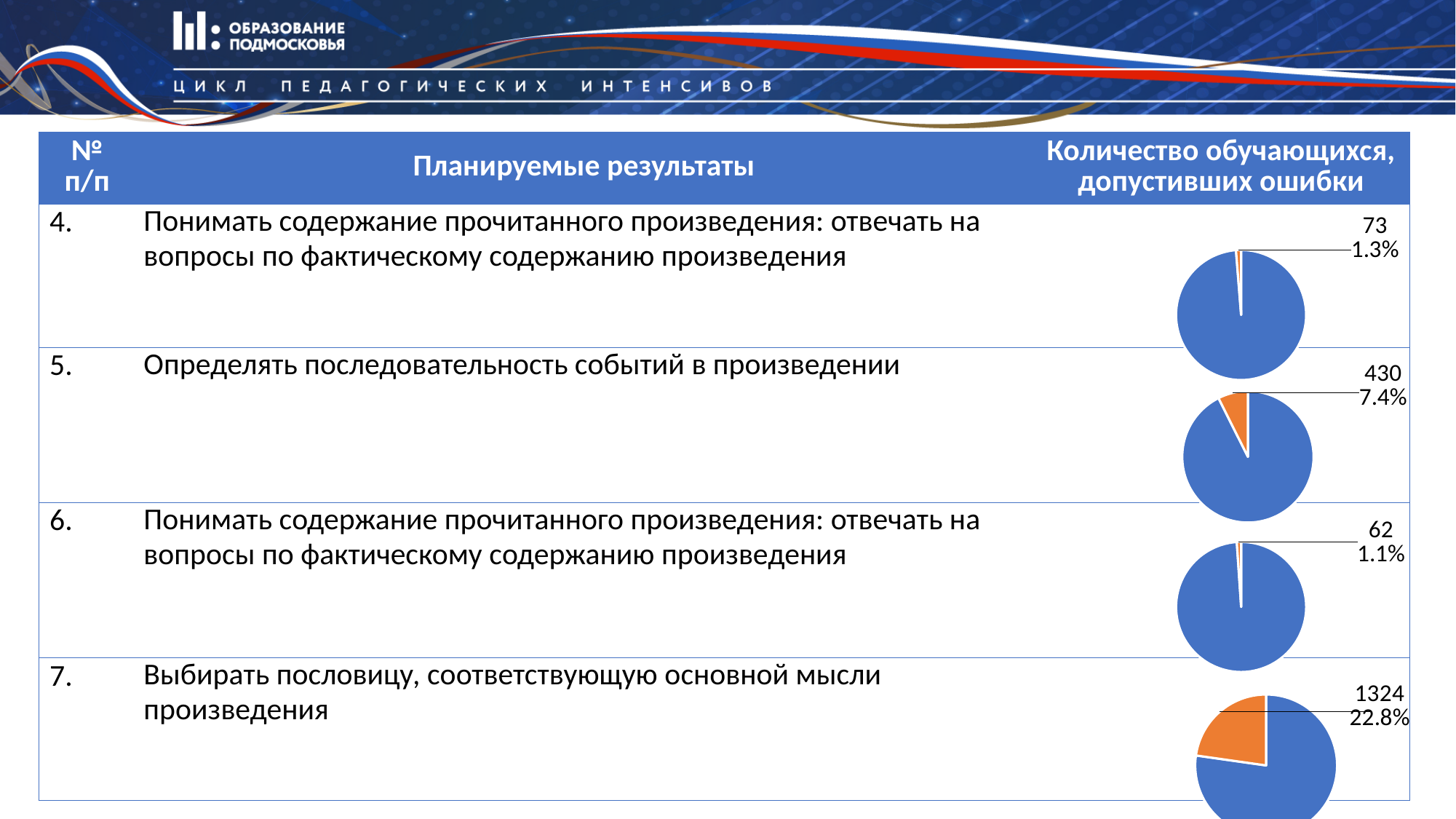
In the pie chart for row 7 (Выбирать пословицу, соответствующую основной мысли произведения), what number is shown on the data label? 1324 In the pie chart for row 7, what share of the pie is the orange slice? 22.8% Which row's pie chart shows the largest number of students who made errors? Row 7 (1324) In the pie chart for row 5, what share of the pie is the orange slice? 7.4% Which row's pie chart shows the smallest number of students who made errors? Row 6 (62) What is the difference between the number of students with errors in row 7 and in row 5? 894 In the pie chart for row 5 (Определять последовательность событий в произведении), what number is shown on the data label? 430 In the pie chart for row 4, what percentage does the orange slice represent? 1.3% In the pie chart for row 4 (Понимать содержание прочитанного произведения), how many students made errors according to the data label? 73 In the pie chart for row 6, how many students made errors according to the data label? 62 What type of chart is used in the right-hand column of the table? Pie chart